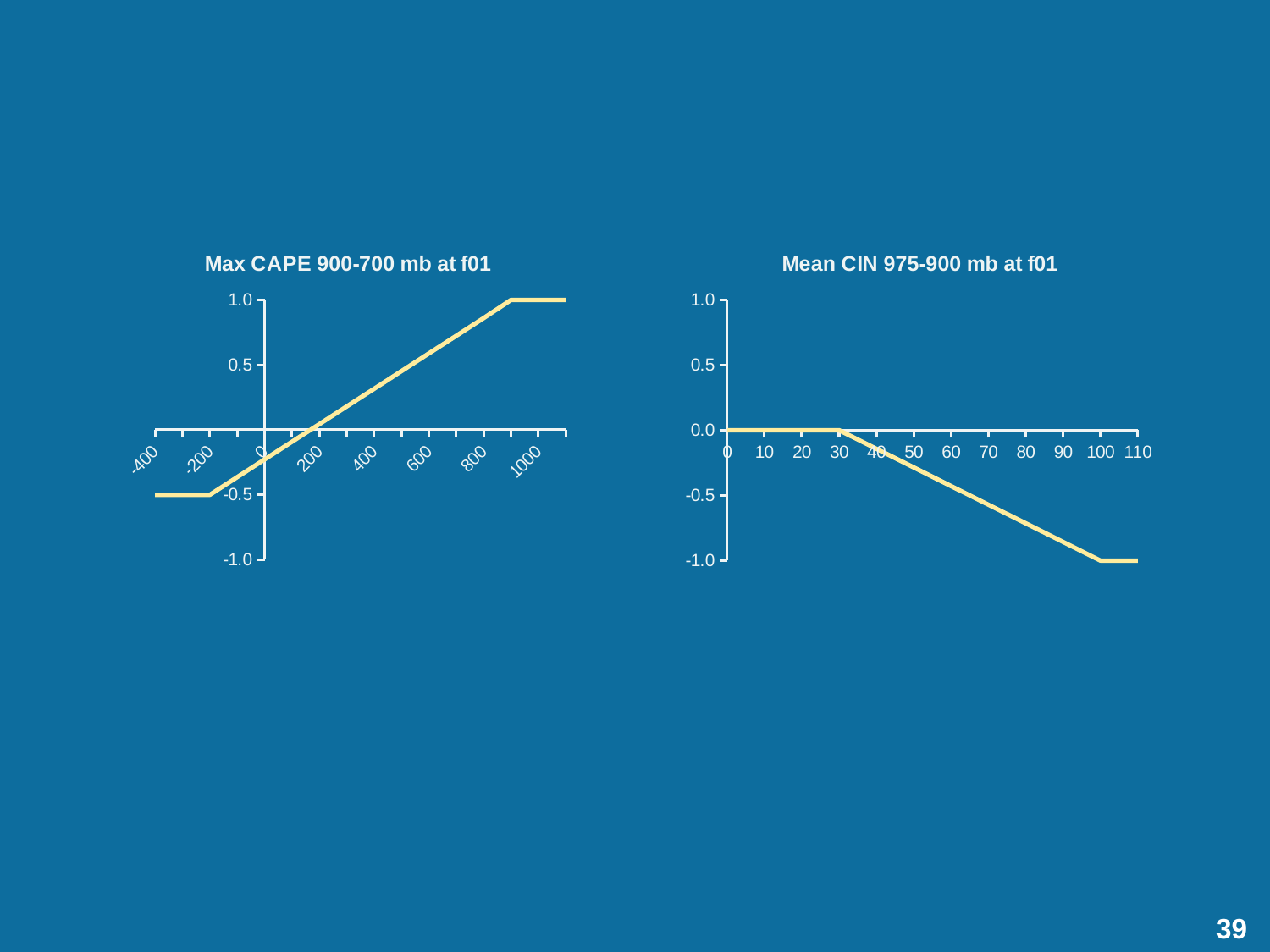
In the "Mean CIN 975-900 mb at f01" chart, which is larger, the y value at x = 20 or the y value at x = 90? x = 20 In the "Mean CIN 975-900 mb at f01" chart, is the y value at x = 80 greater or less than -0.5? less In the "Max CAPE 900-700 mb at f01" chart, is the y value at x = 600 greater or less than 0.5? greater In the "Max CAPE 900-700 mb at f01" chart, what is the y value of the line at x = 1000? 1.0 What kind of chart is "Max CAPE 900-700 mb at f01"? line chart What is the title of the chart on the right side of the slide? Mean CIN 975-900 mb at f01 In the "Max CAPE 900-700 mb at f01" chart, what is the y value of the line at x = -400? -0.5 In the "Mean CIN 975-900 mb at f01" chart, what is the y value of the line at x = 110? -1.0 In the "Mean CIN 975-900 mb at f01" chart, does the line rise or fall as the x value increases from 30 to 100? fall What kind of chart is "Mean CIN 975-900 mb at f01"? line chart In the "Mean CIN 975-900 mb at f01" chart, what is the y value of the line at x = 10? 0.0 In the "Max CAPE 900-700 mb at f01" chart, does the line rise or fall as the x value increases from -200 to 800? rise